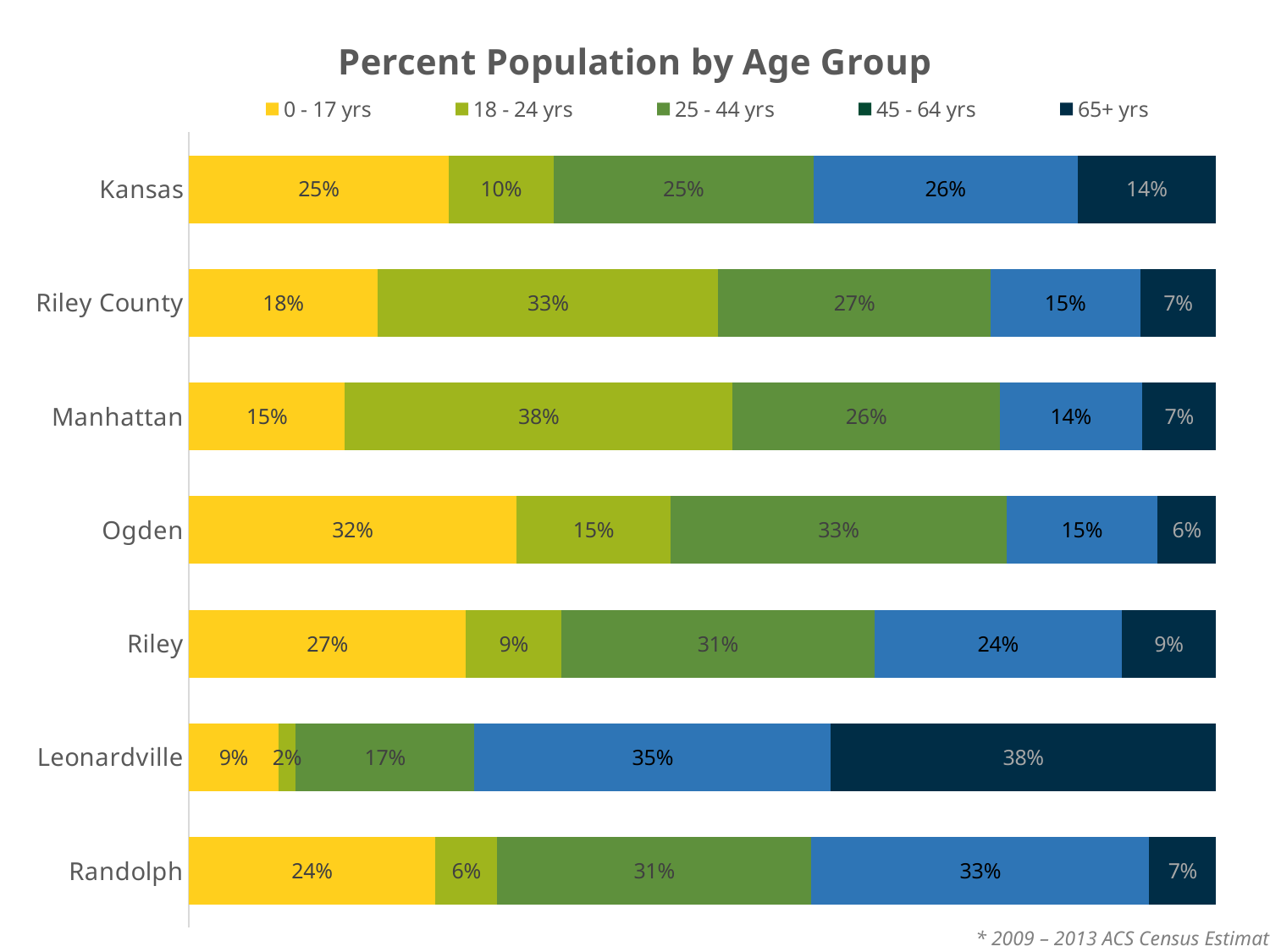
Which location has the highest value for the 0 - 17 yrs age group? Ogden Which location has the lowest value for the 18 - 24 yrs age group? Leonardville Which has a larger 45 - 64 yrs value, Randolph or Riley? Randolph How many locations are shown on the chart? 7 What share of Ogden's population is 0 - 17 yrs? 32% What is the total of the stacked bar for Kansas? 100% How much larger is the 18 - 24 yrs value for Riley County than for Kansas? 23 percentage points What is the title of the chart? Percent Population by Age Group What type of chart is shown on the slide? Stacked bar chart What is the value for the 65+ yrs age group in Leonardville? 38% How many age groups does the legend list? 5 What percentage of Manhattan's population is in the 18 - 24 yrs age group? 38%